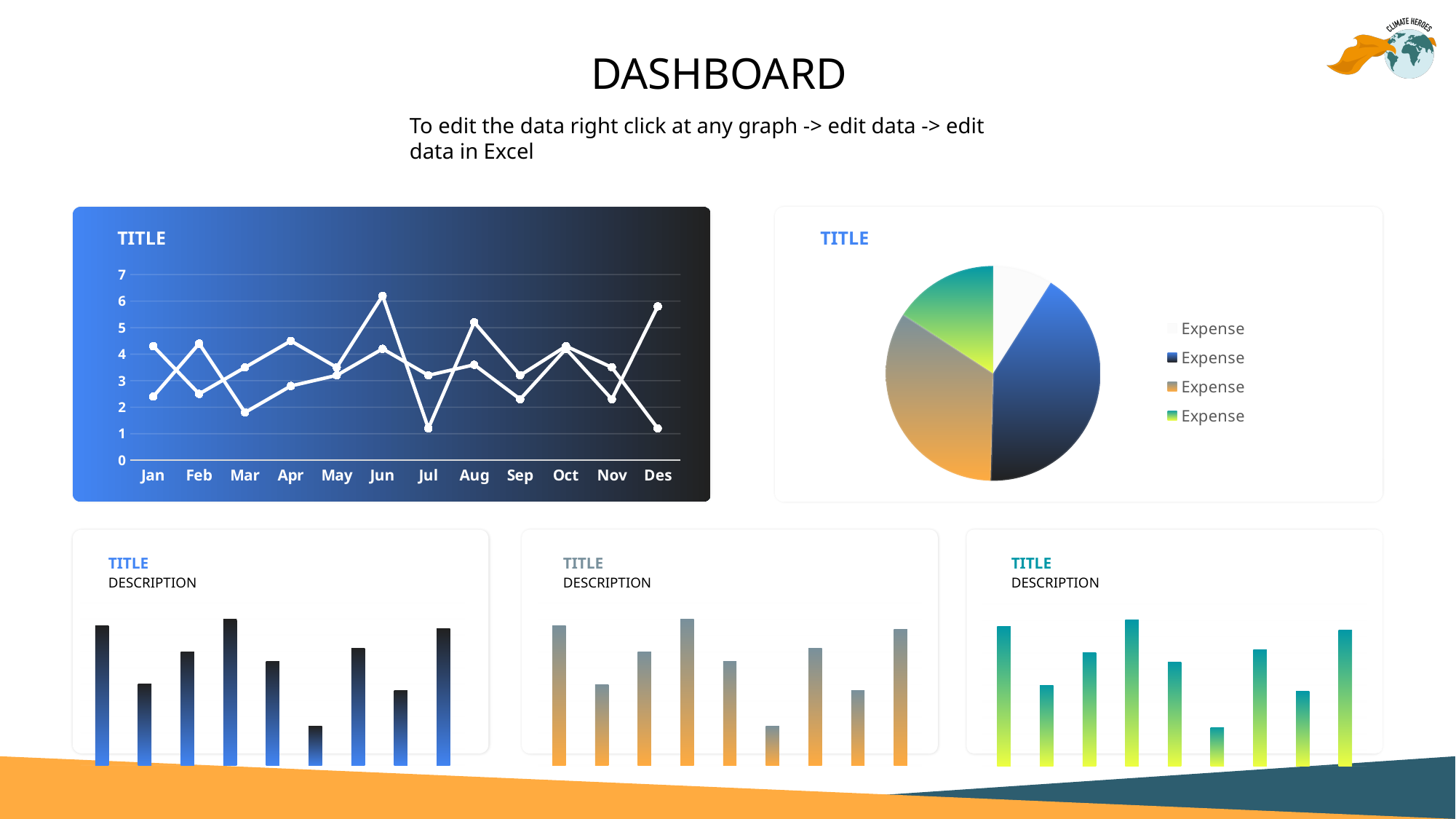
What kind of chart is the bottom-left chart on the slide? bar chart How many months are shown on the x axis of the top-left line chart? 12 How many slices does the top-right pie chart have? 4 In the top-left line chart, is the highest point plotted for Jun greater or less than 5? greater What kind of chart is the top-right chart on the slide? pie chart In the top-left line chart, what is the highest value shown on the y axis? 7 In the bottom-right bar chart, which bar is the shortest, counting from the left? the 6th bar In the top-left line chart, is the highest point plotted for Des greater or less than 5? greater How many bars are in the bottom-left bar chart? 9 In the top-left line chart, is the lowest point plotted for Jul greater or less than 2? less What kind of chart is the top-left chart on the slide? line chart How many entries does the legend of the top-right pie chart list? 4